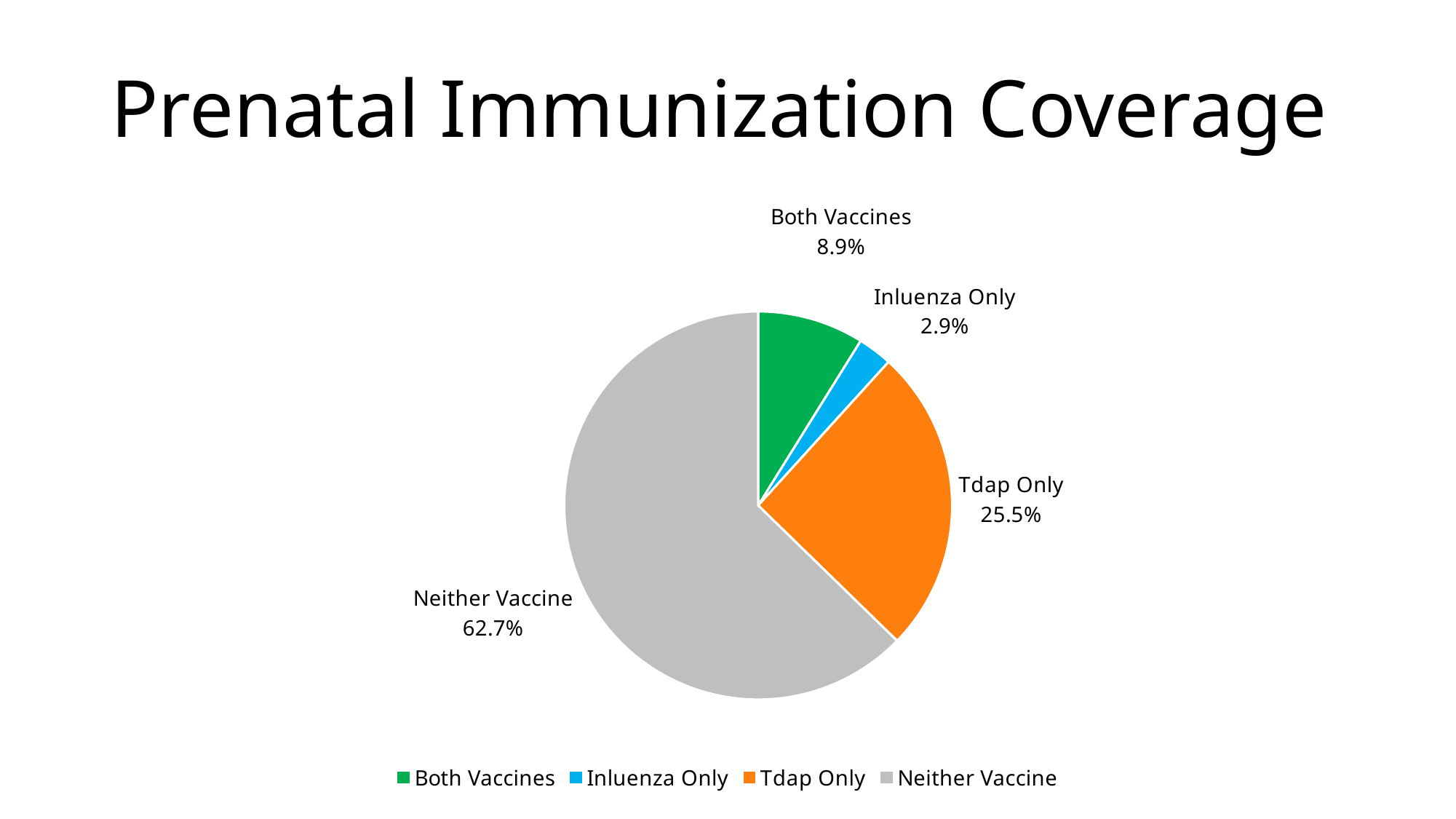
What percentage is shown for Tdap Only? 25.5% How many slices does the pie chart have? 4 What is the difference in percentage points between Neither Vaccine and Tdap Only? 37.2 Which is larger, Both Vaccines or Inluenza Only? Both Vaccines What percentage is shown for Inluenza Only? 2.9% Which slice of the pie is the smallest? Inluenza Only What is the title of the chart? Prenatal Immunization Coverage What percentage of the pie is labelled Neither Vaccine? 62.7% What percentage is shown for Both Vaccines? 8.9% What kind of chart is shown on the slide? Pie chart Which slice of the pie is the largest? Neither Vaccine What colour is the Tdap Only slice? Orange